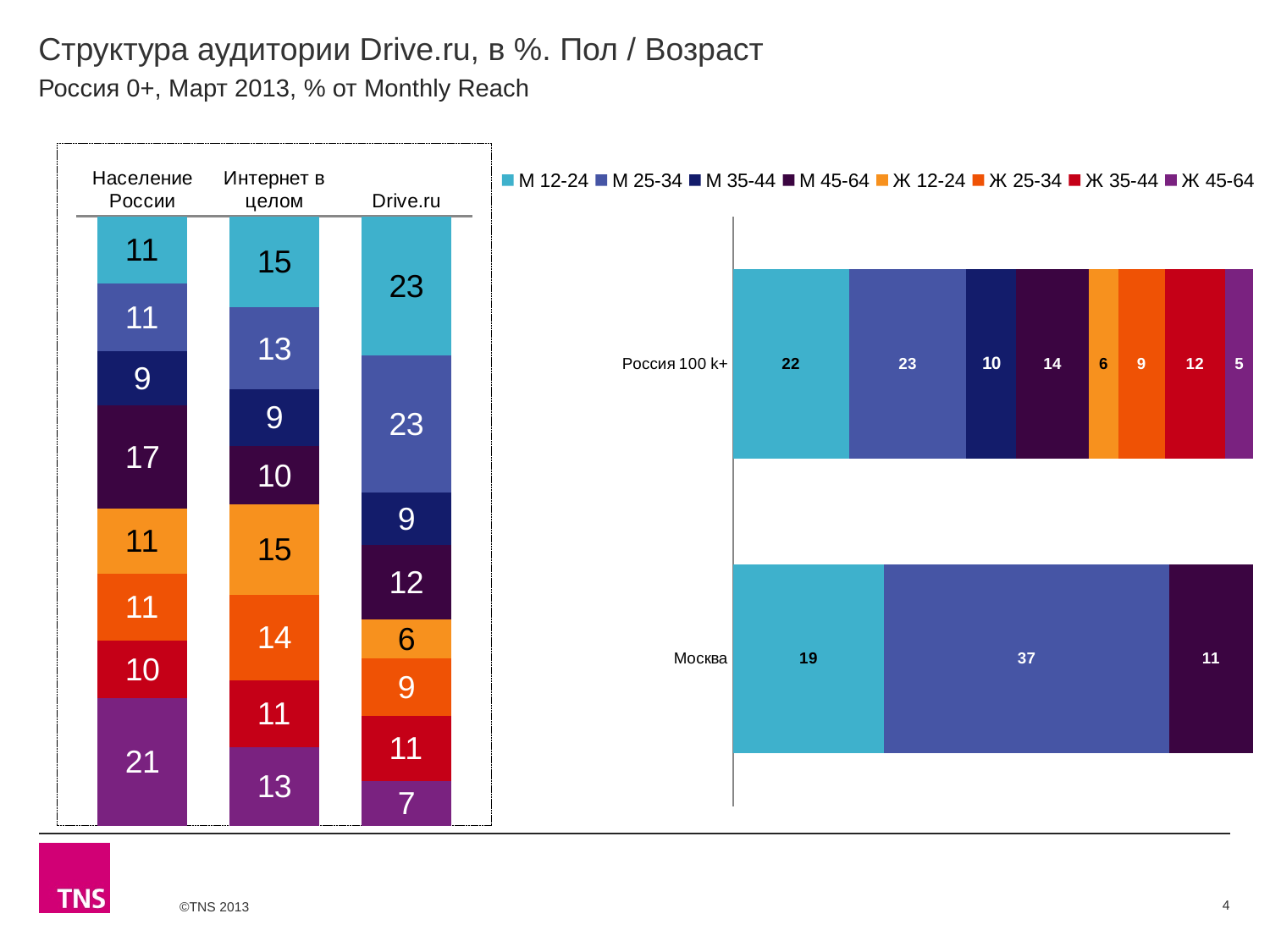
In the left chart, what is the value of the top (М 12-24) segment for Drive.ru? 23 What kind of chart is the right chart? Stacked bar chart In the right chart, what is the value for М 25-34 in the Москва bar? 37 In the left chart, what is the difference between the Ж 45-64 (purple) segment for Население России and for Drive.ru? 14 In the right chart, which segment of the Россия 100 k+ bar is the largest? М 25-34 In the right chart, what is the value for М 25-34 in the Россия 100 k+ bar? 23 In the left chart, what is the value of the Ж 45-64 (purple) segment for Население России? 21 In the right chart, which segment of the Россия 100 k+ bar is the smallest? Ж 45-64 In the right chart, what is the value for Ж 45-64 in the Россия 100 k+ bar? 5 How many series does the legend on the right chart list? 8 In the right chart, what is the difference between М 12-24 for Россия 100 k+ and М 12-24 for Москва? 3 In the left chart, which is larger: the Ж 12-24 (orange) segment for Интернет в целом or for Drive.ru? Интернет в целом